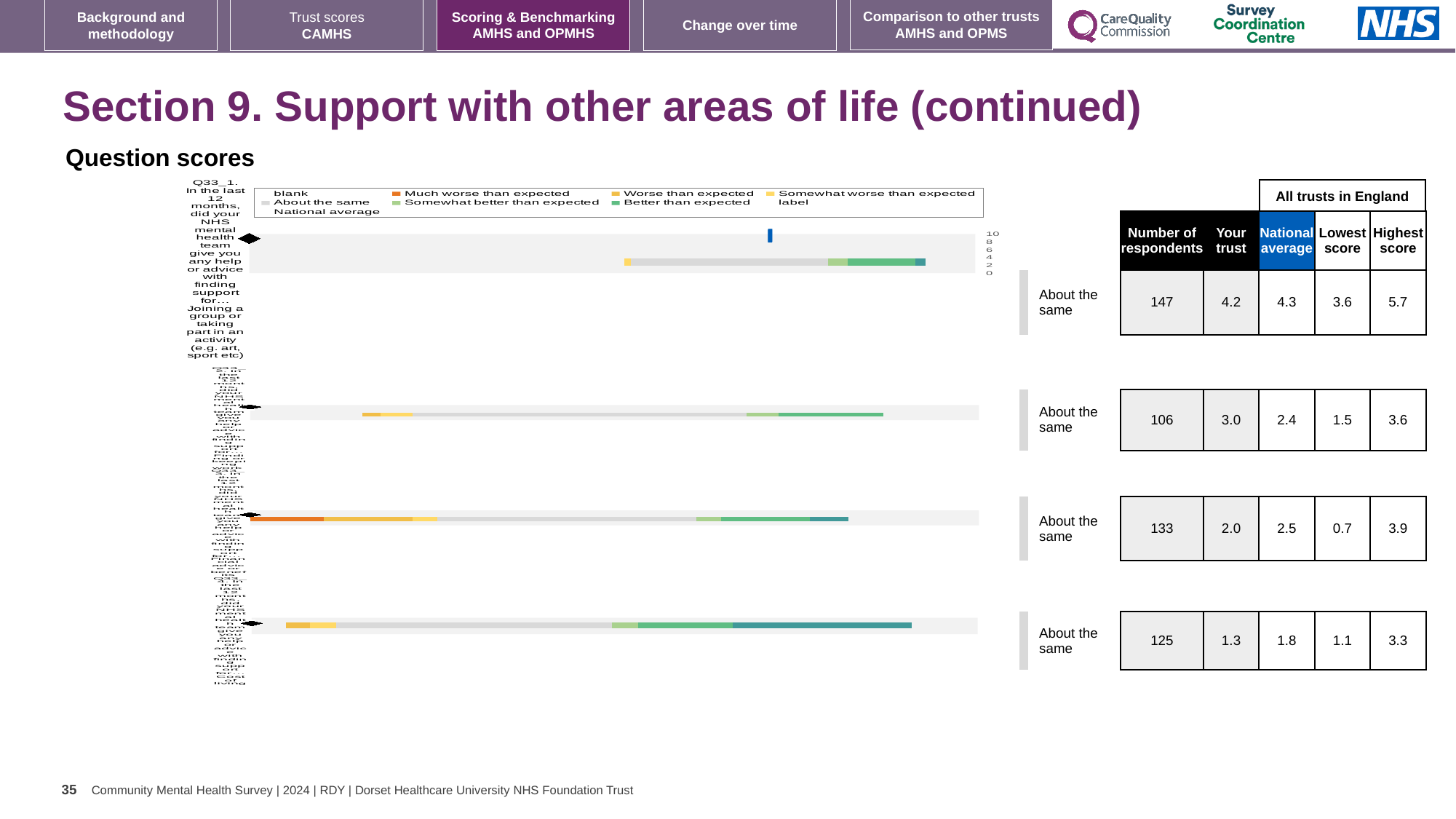
What is the 'Your trust' score for the first question (Q33_1) in the table beside the chart? 4.2 What is the lowest 'Your trust' score shown in the table beside the chart? 1.3 Which bar has the highest 'Your trust' score in the table beside the chart? The first (top) bar, Q33_1, with 4.2 What is the national average for the first question (Q33_1) in the table beside the chart? 4.3 How many horizontal bars are plotted in the question scores chart? 4 In the table beside the chart, what is the number of respondents for the first question (Q33_1, joining a group or taking part in an activity)? 147 What benchmark category label is shown to the right of each of the four bars? About the same What is the number of respondents for the second bar from the top in the table beside the chart? 106 For the first question (Q33_1), which is larger: the 'Your trust' score or the national average? National average For the first question (Q33_1), what is the difference between the highest score and the lowest score across all trusts in England? 2.1 What kind of chart is shown under 'Question scores'? Bar chart